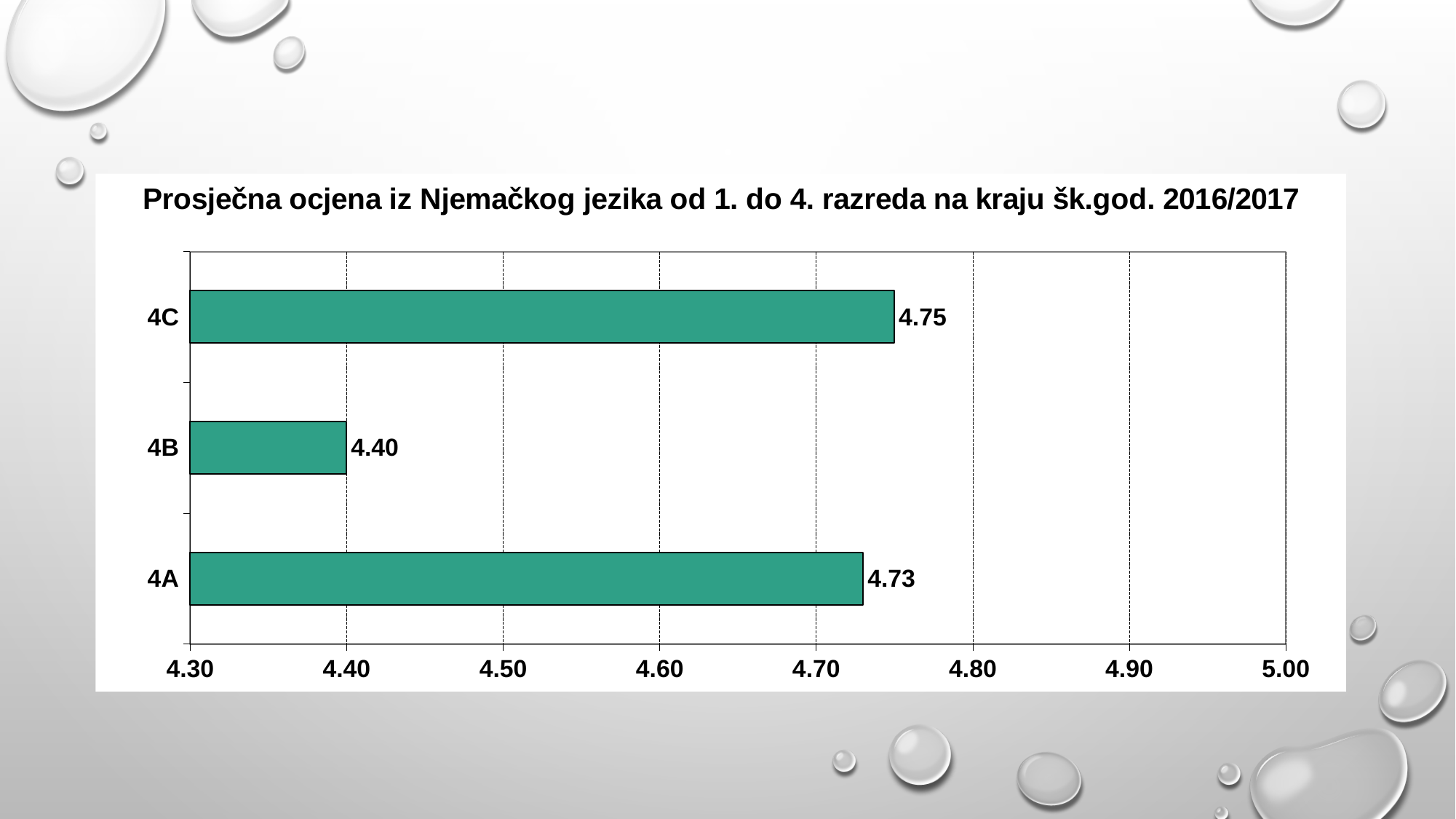
What is the average grade for class 4A? 4.73 What kind of chart is shown on the slide? Bar chart What is the difference between the average grades of 4A and 4B? 0.33 What is the title of the chart? Prosječna ocjena iz Njemačkog jezika od 1. do 4. razreda na kraju šk.god. 2016/2017 Which class has the lowest average grade? 4B Which class has a higher average grade, 4A or 4B? 4A How many classes are shown in the chart? 3 Is the value for 4A greater or less than 4.60? greater What is the average grade for class 4B? 4.40 Which class has the highest average grade? 4C What is the difference between the average grades of 4C and 4B? 0.35 What is the average grade for class 4C? 4.75